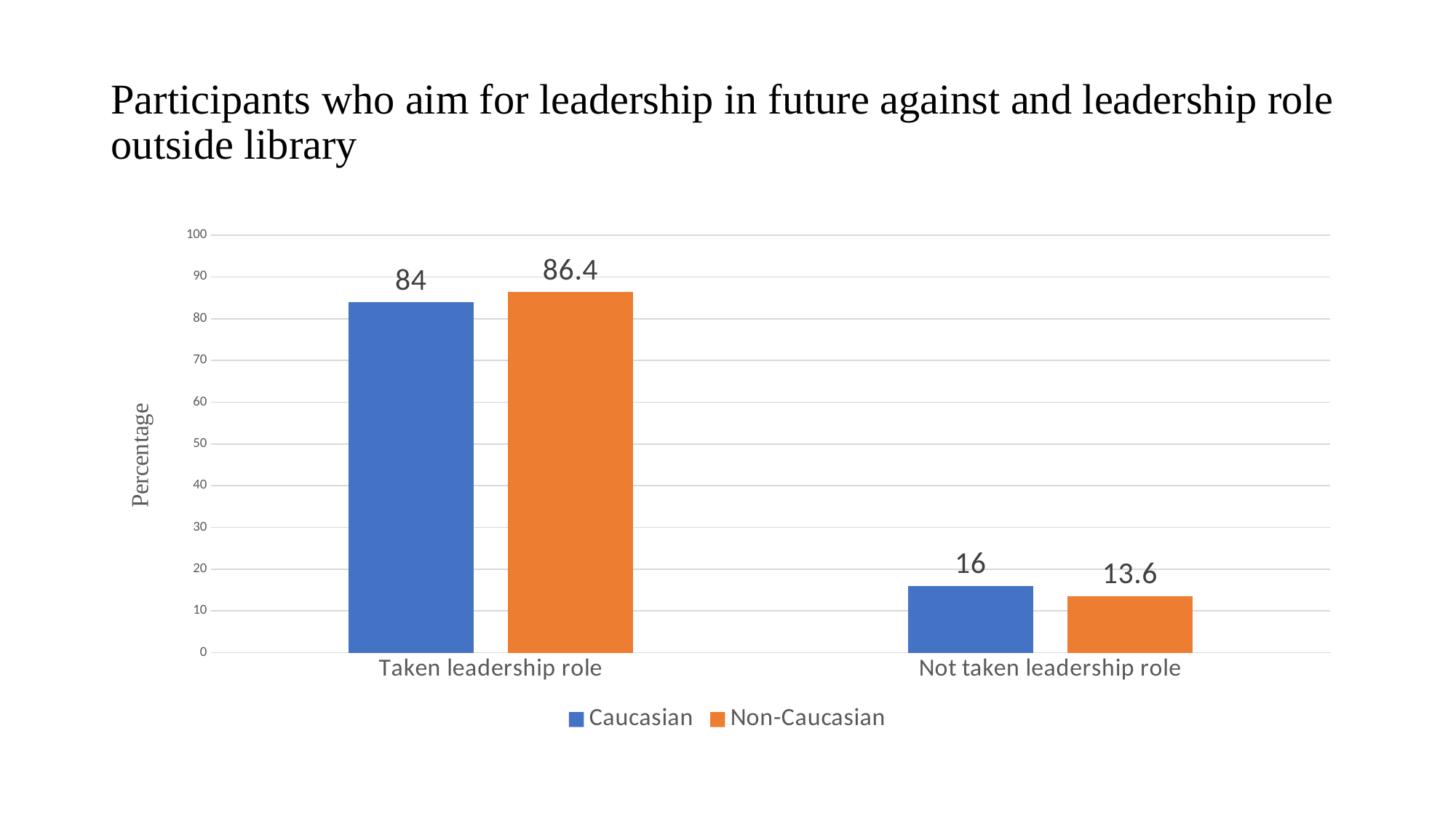
How many categories are shown on the x axis? 2 How many series does the legend list? 2 What is the difference between the Non-Caucasian and Caucasian values for 'Taken leadership role'? 2.4 What is the value for Non-Caucasian participants who have not taken a leadership role? 13.6 What is the value for Caucasian participants who have taken a leadership role? 84 Which bar has the highest value in the chart? Non-Caucasian, Taken leadership role What is the value for Caucasian participants who have not taken a leadership role? 16 What kind of chart is shown on the slide? Bar chart Which series has the higher value for 'Taken leadership role'? Non-Caucasian What is the value for Non-Caucasian participants who have taken a leadership role? 86.4 What is the difference between the Caucasian and Non-Caucasian values for 'Not taken leadership role'? 2.4 Which series has the lower value for 'Not taken leadership role'? Non-Caucasian